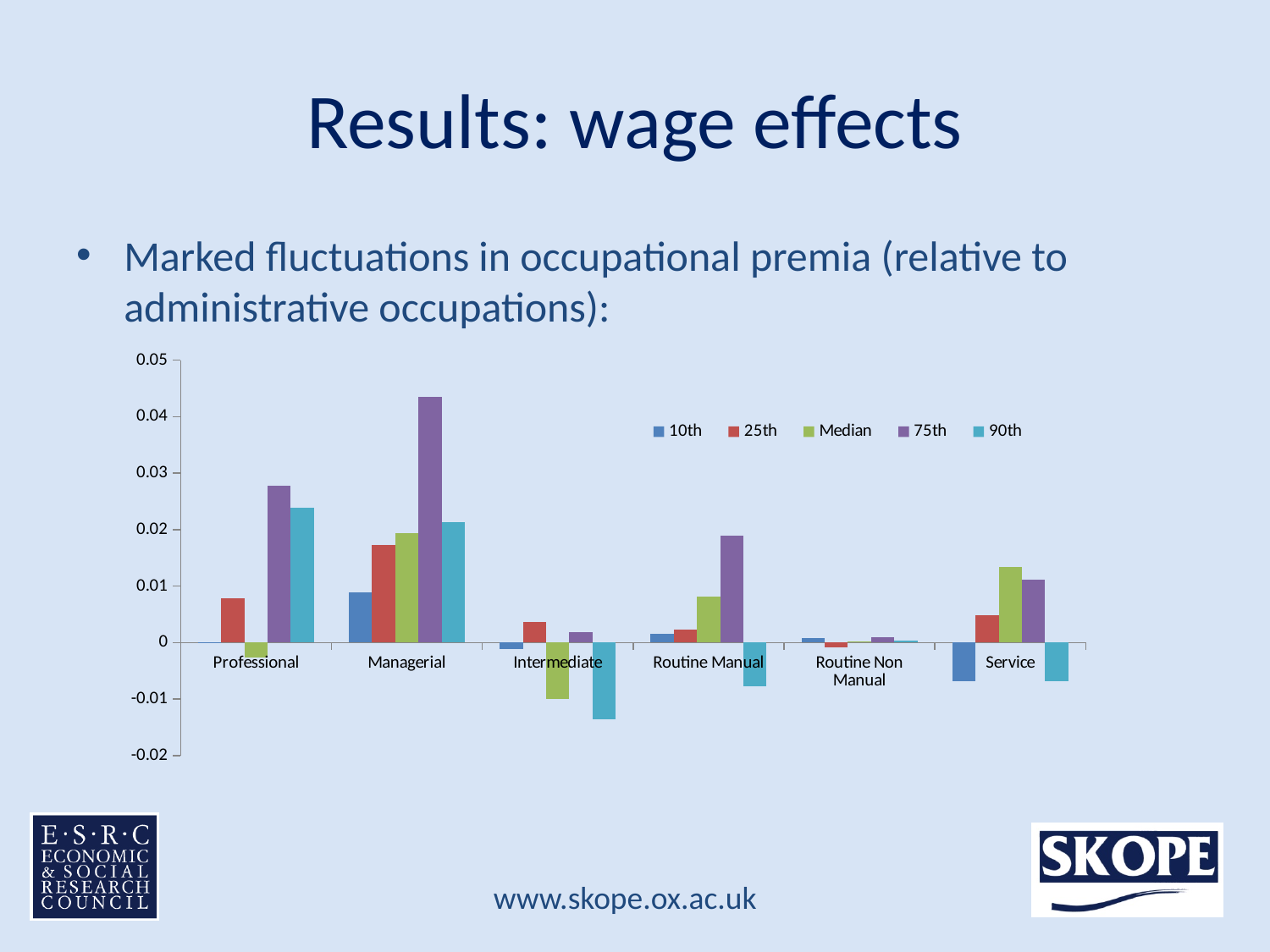
Which is larger: the 75th value for Managerial or the 75th value for Professional? Managerial Which is larger: the Median value for Service or the 10th value for Service? Median What are the entries listed in the chart legend? 10th, 25th, Median, 75th, 90th How many series does the legend list? 5 Which category has the lowest value for the 90th series? Intermediate Is the value for the 75th series in Professional greater or less than 0.02? greater Which category has the highest value for the Median series? Managerial How many occupational categories are shown on the x axis? 6 Which category has the highest value for the 75th series? Managerial What kind of chart is shown on the slide? bar chart Is the value for the Median series in Intermediate greater or less than 0? less Is the value for the 75th series in Managerial greater or less than 0.04? greater